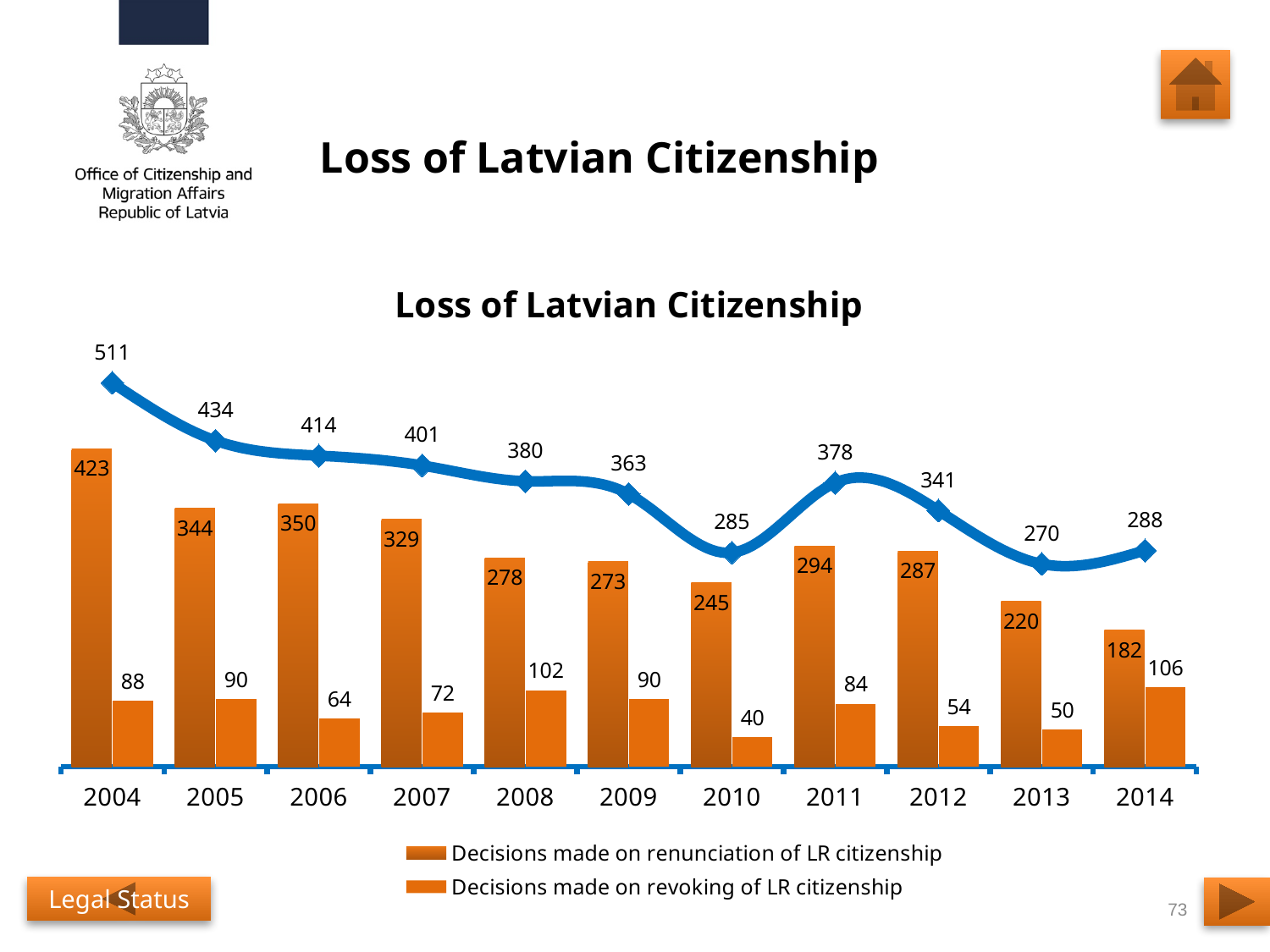
What value does the line show for 2011? 378 Do the decisions on renunciation of LR citizenship generally rise or fall from 2004 to 2014? Fall Which year had more decisions on renunciation of LR citizenship, 2005 or 2006? 2006 How many series does the legend list? 2 In which year were decisions on revoking of LR citizenship lowest? 2010 How many years are shown on the x axis? 11 What is the difference between decisions on renunciation and decisions on revoking of LR citizenship in 2014? 76 In which year were decisions on renunciation of LR citizenship highest? 2004 What kind of chart is shown on the slide? A combined bar and line chart In which year were decisions on revoking of LR citizenship highest? 2014 How many decisions were made on renunciation of LR citizenship in 2004? 423 How many decisions were made on revoking of LR citizenship in 2010? 40